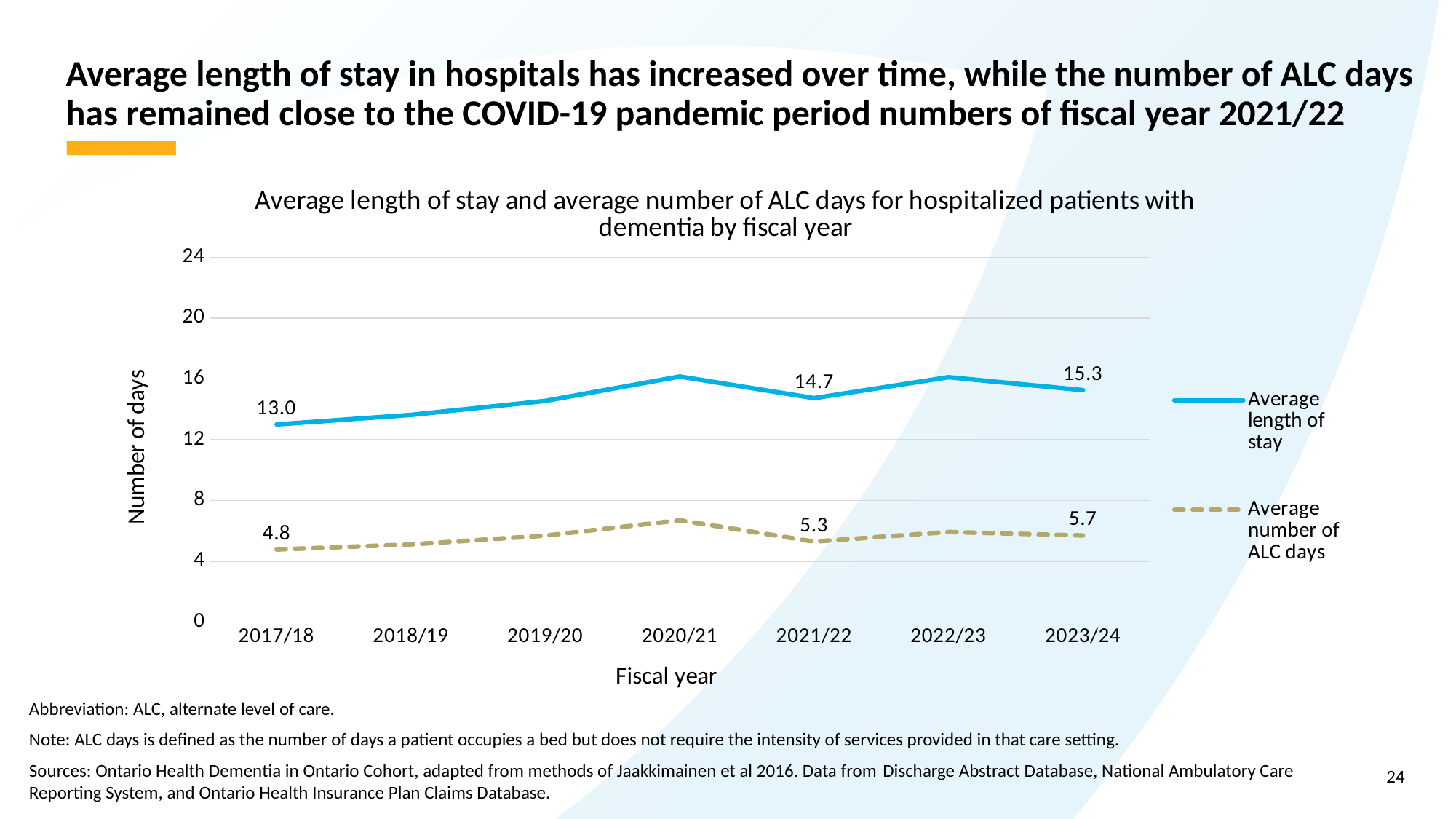
Is the average number of ALC days in 2020/21 greater or less than 8? less What is the average length of stay in fiscal year 2017/18? 13.0 What is the difference between the average number of ALC days in 2023/24 and in 2021/22? 0.4 What is the average number of ALC days in fiscal year 2017/18? 4.8 By how much did the average length of stay increase from 2017/18 to 2023/24? 2.3 How many fiscal years are shown on the x axis? 7 How many series does the legend list? 2 What type of chart is shown on the slide? Line chart What is the average number of ALC days in fiscal year 2023/24? 5.7 What is the average length of stay in fiscal year 2021/22? 14.7 Which is larger in 2021/22: the average length of stay or the average number of ALC days? Average length of stay